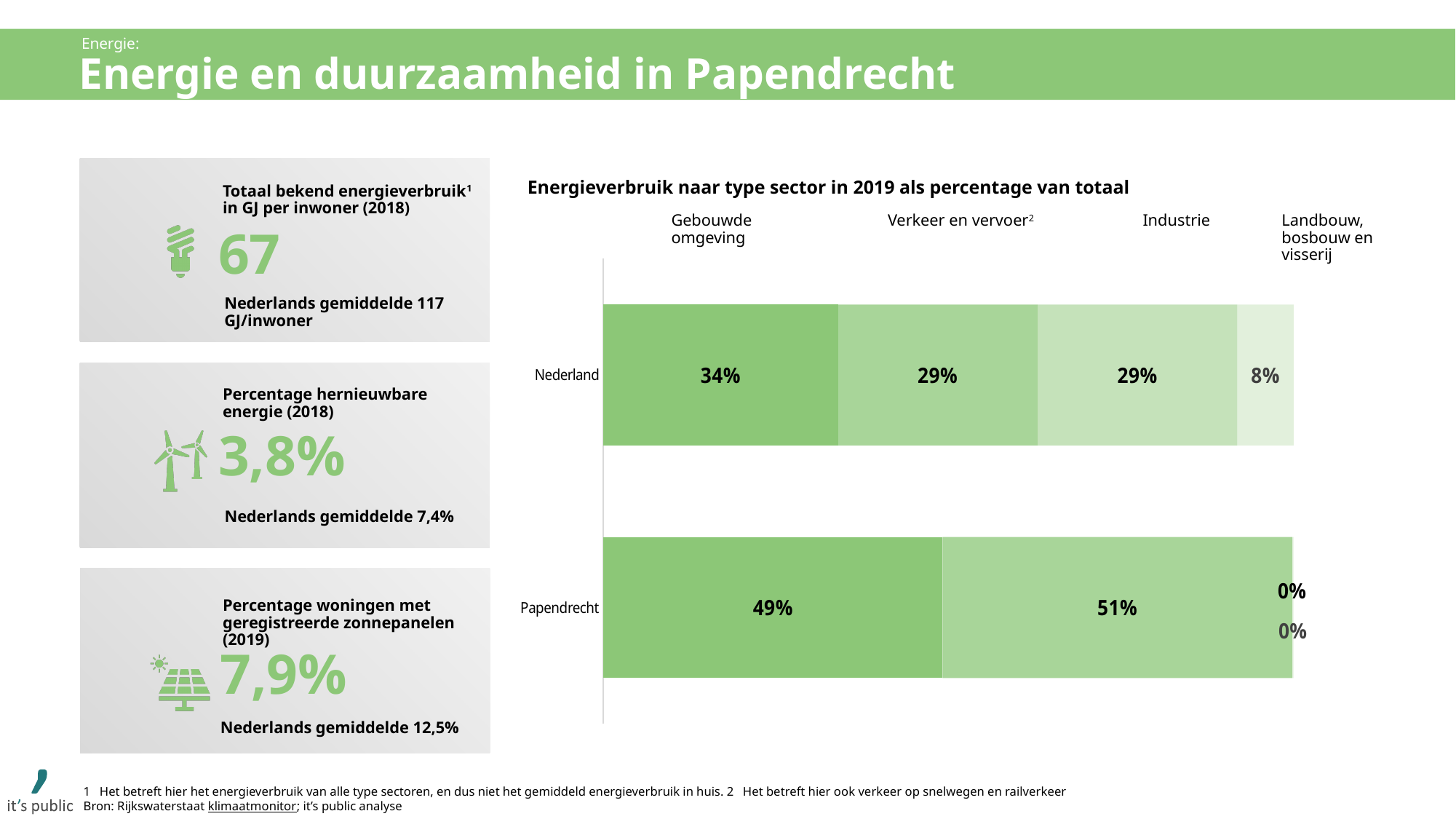
Which sector has the lowest share for Nederland? Landbouw, bosbouw en visserij What is the value for Gebouwde omgeving for Nederland in the chart 'Energieverbruik naar type sector in 2019 als percentage van totaal'? 34% What is the difference between the Gebouwde omgeving share for Papendrecht and for Nederland? 15% What is the value for Landbouw, bosbouw en visserij for Nederland? 8% What is the value for Verkeer en vervoer for Papendrecht? 51% Which is larger: the Verkeer en vervoer share for Nederland or for Papendrecht? Papendrecht Which sector has the highest share for Papendrecht? Verkeer en vervoer How many sector series does the chart show? 4 What is the title of the chart on the slide? Energieverbruik naar type sector in 2019 als percentage van totaal How many regions (bars) are shown in the chart? 2 What kind of chart is shown on the slide? Stacked bar chart What is the value for Industrie for Papendrecht? 0%